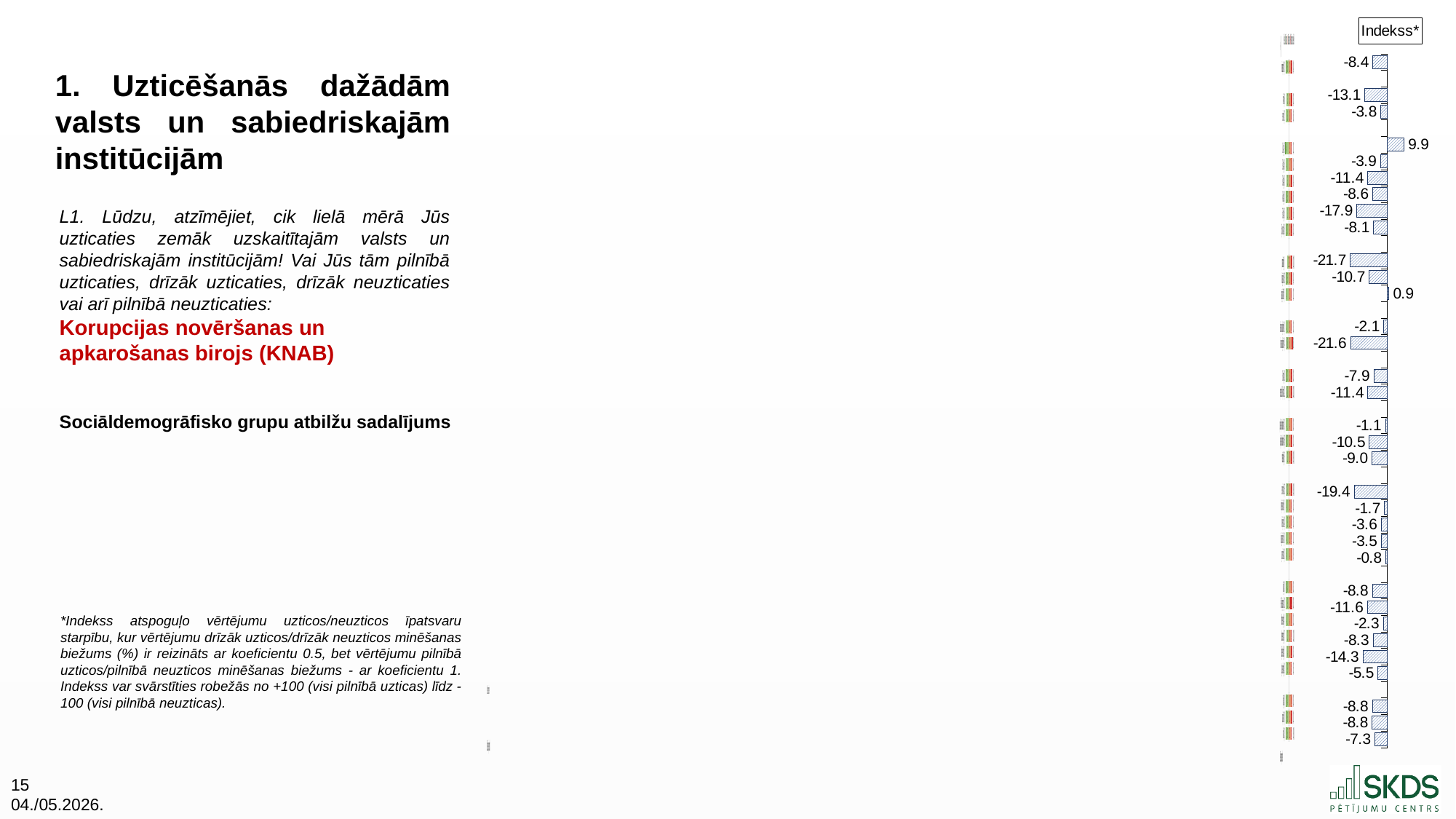
In the Indekss* chart, what is the difference between the highest value 9.9 and the lowest value -21.7? 31.6 What kind of chart is the Indekss* chart on the right side of the slide? bar chart What is the highest value printed in the Indekss* chart? 9.9 In the Indekss* chart, which is larger, the value 9.9 or the value 0.9? 9.9 How many positive values are printed in the Indekss* chart? 2 What is the title shown above the index chart on the right of the slide? Indekss* What is the lowest value printed in the Indekss* chart? -21.7